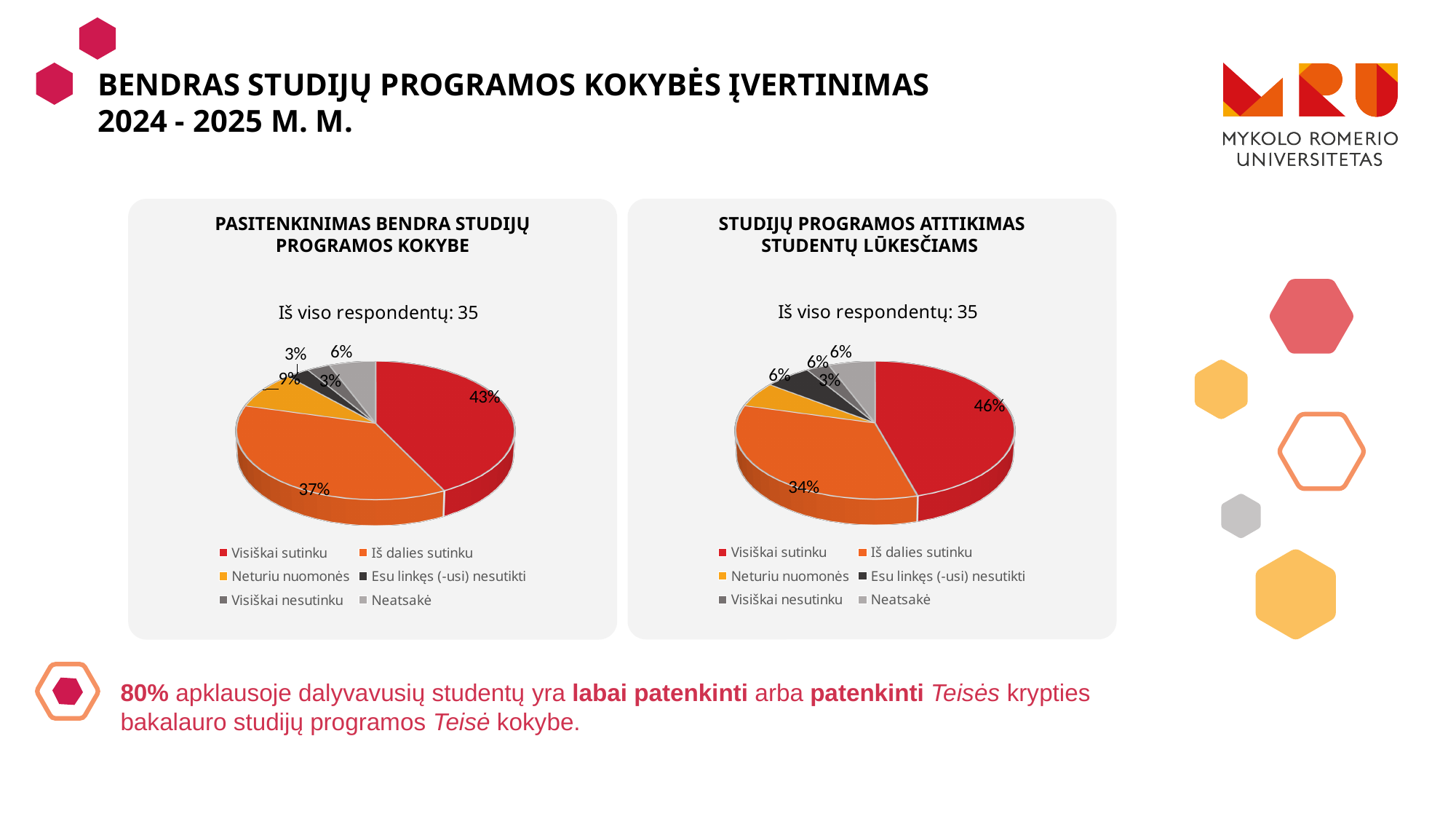
In the right chart (Studijų programos atitikimas studentų lūkesčiams), what share of respondents answered "Visiškai sutinku"? 46% In the right chart (Studijų programos atitikimas studentų lūkesčiams), which category has the largest slice? Visiškai sutinku In the left chart (Pasitenkinimas bendra studijų programos kokybe), what share of respondents answered "Visiškai sutinku"? 43% How many respondents in total are reported for the right chart (Studijų programos atitikimas studentų lūkesčiams)? 35 In the left chart (Pasitenkinimas bendra studijų programos kokybe), what share of respondents answered "Neturiu nuomonės"? 9% In the left chart (Pasitenkinimas bendra studijų programos kokybe), what share of respondents answered "Iš dalies sutinku"? 37% In the right chart (Studijų programos atitikimas studentų lūkesčiams), what is the difference between the "Visiškai sutinku" and "Iš dalies sutinku" shares? 12% Which chart has the larger "Visiškai sutinku" share, the left chart or the right chart? The right chart What type of chart is used on this slide? Pie chart How many categories does the legend of the left chart list? 6 In the right chart (Studijų programos atitikimas studentų lūkesčiams), what share of respondents answered "Iš dalies sutinku"? 34% In the left chart (Pasitenkinimas bendra studijų programos kokybe), what is the difference between the "Visiškai sutinku" and "Iš dalies sutinku" shares? 6%